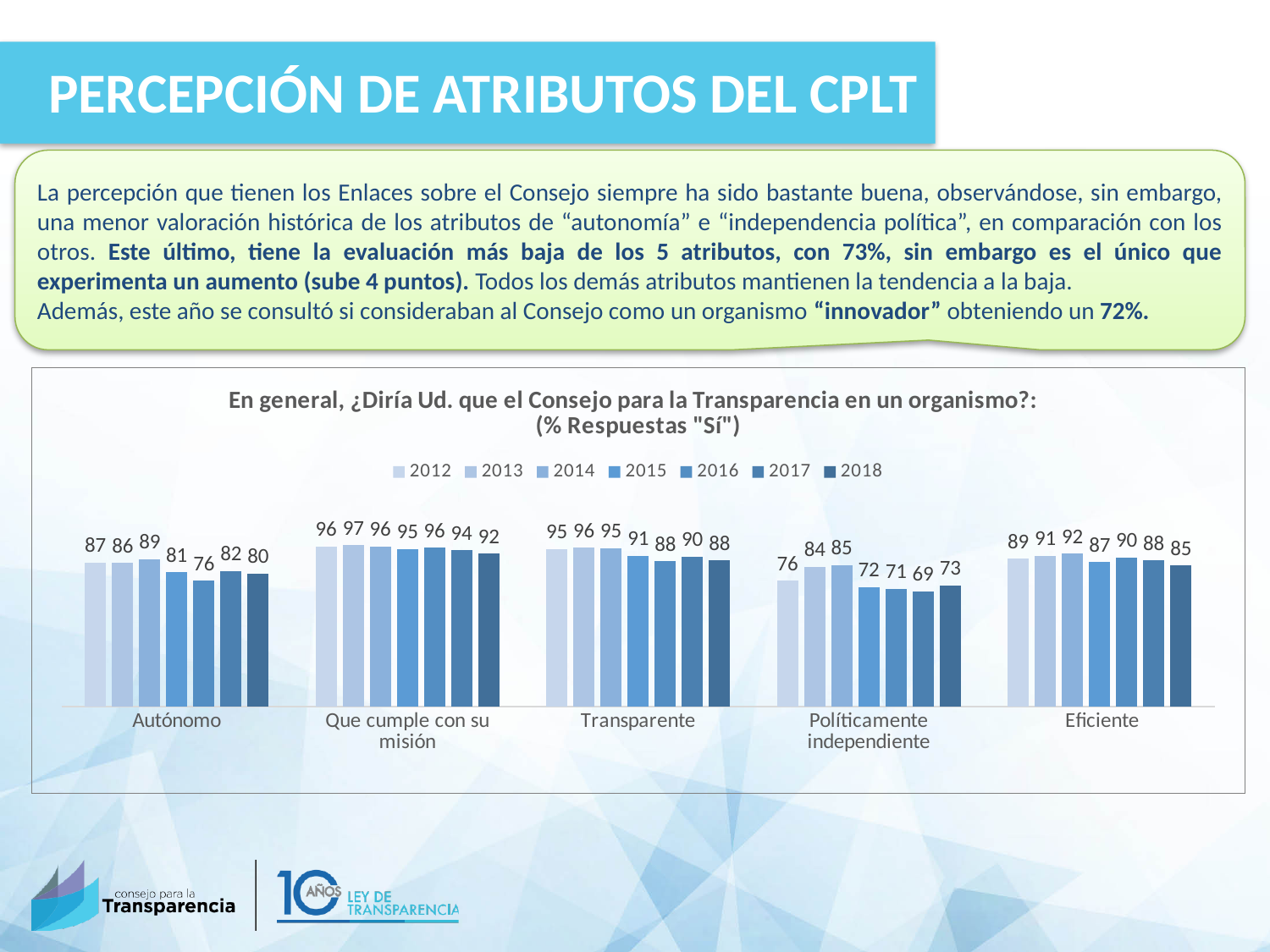
What is the difference between the 2017 and 2018 values for "Políticamente independiente"? 4 Which category has the highest 2012 value? Que cumple con su misión Which category has the lowest 2018 value? Políticamente independiente What type of chart is shown on the slide? bar chart What is the 2013 value for "Que cumple con su misión"? 97 How many attribute categories are shown on the x axis of the chart? 5 How many series does the chart legend list? 7 What is the 2016 value for "Autónomo"? 76 What is the 2018 value for "Políticamente independiente"? 73 For "Eficiente", do the values rise or fall from 2016 to 2018? fall What is the title of the chart? En general, ¿Diría Ud. que el Consejo para la Transparencia en un organismo?: (% Respuestas "Sí") Which is larger: the 2018 value for "Transparente" or the 2018 value for "Eficiente"? Transparente